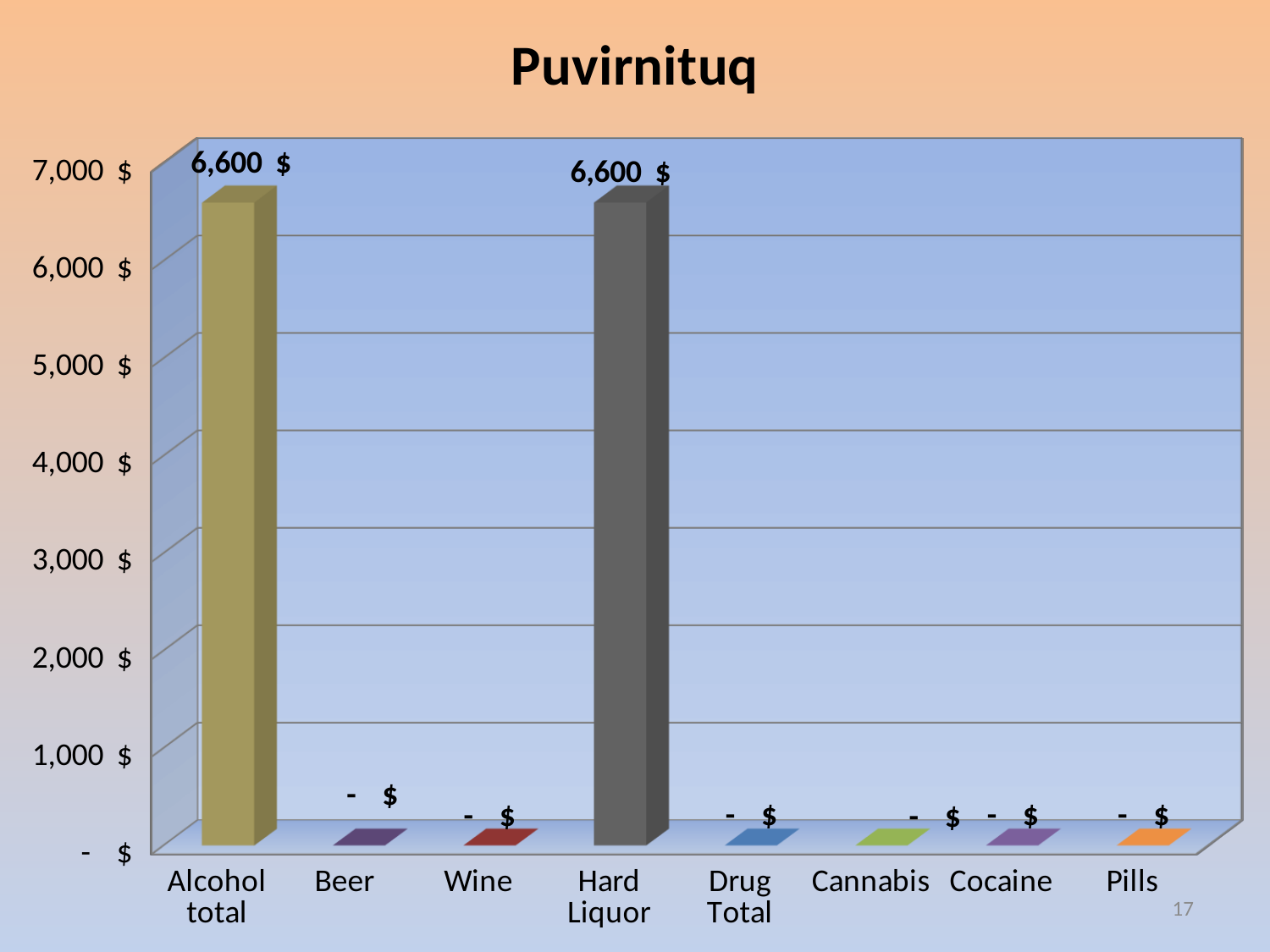
What is the title of the chart? Puvirnituq How many categories are shown on the x axis? 8 What is the value for Alcohol total? 6,600 $ What is the value shown for Beer? - $ Which is larger, the value for Hard Liquor or the value for Wine? Hard Liquor Which category has a larger value, Cannabis or Alcohol total? Alcohol total What is the difference between the values for Alcohol total and Hard Liquor? 0 $ What is the value shown for Drug Total? - $ Is the value for Hard Liquor greater or less than 6,000 $? greater Is the value for Alcohol total greater or less than 7,000 $? less What kind of chart is this? bar chart What is the value for Hard Liquor? 6,600 $